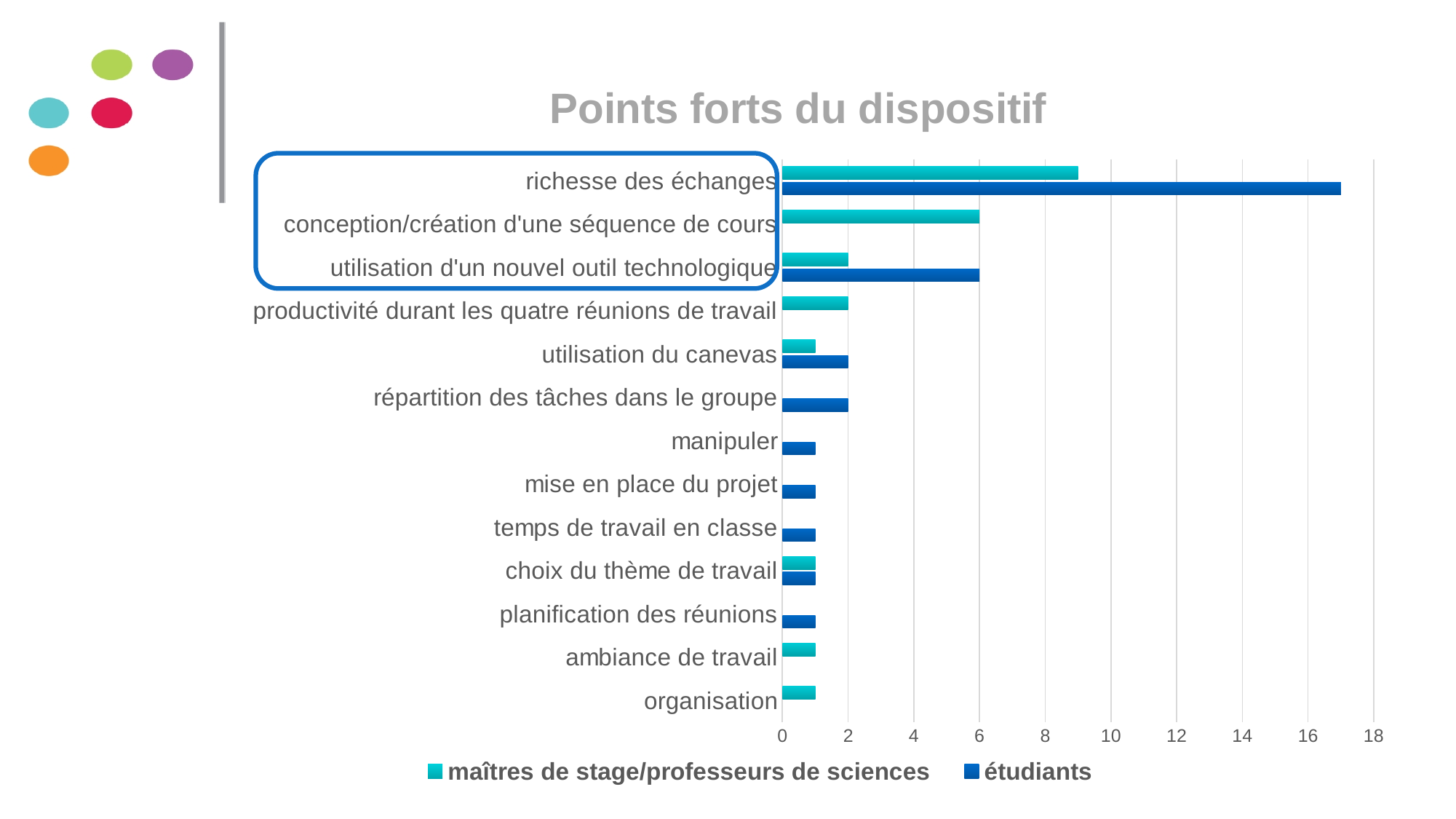
What is the 'étudiants' value for 'utilisation d'un nouvel outil technologique'? 6 Is the 'étudiants' value for 'richesse des échanges' greater or less than 16? greater What type of chart is shown on the slide? bar chart What is the title of the chart? Points forts du dispositif How many series does the legend list? 2 For 'richesse des échanges', which series has the larger value: 'étudiants' or 'maîtres de stage/professeurs de sciences'? étudiants Which category has the highest value for the 'étudiants' series? richesse des échanges What is the 'maîtres de stage/professeurs de sciences' value for 'conception/création d'une séquence de cours'? 6 Is the 'maîtres de stage/professeurs de sciences' value for 'richesse des échanges' greater or less than 8? greater How many categories are shown on the vertical axis of the chart? 13 What is the 'étudiants' value for 'répartition des tâches dans le groupe'? 2 Which category has the highest value for the 'maîtres de stage/professeurs de sciences' series? richesse des échanges